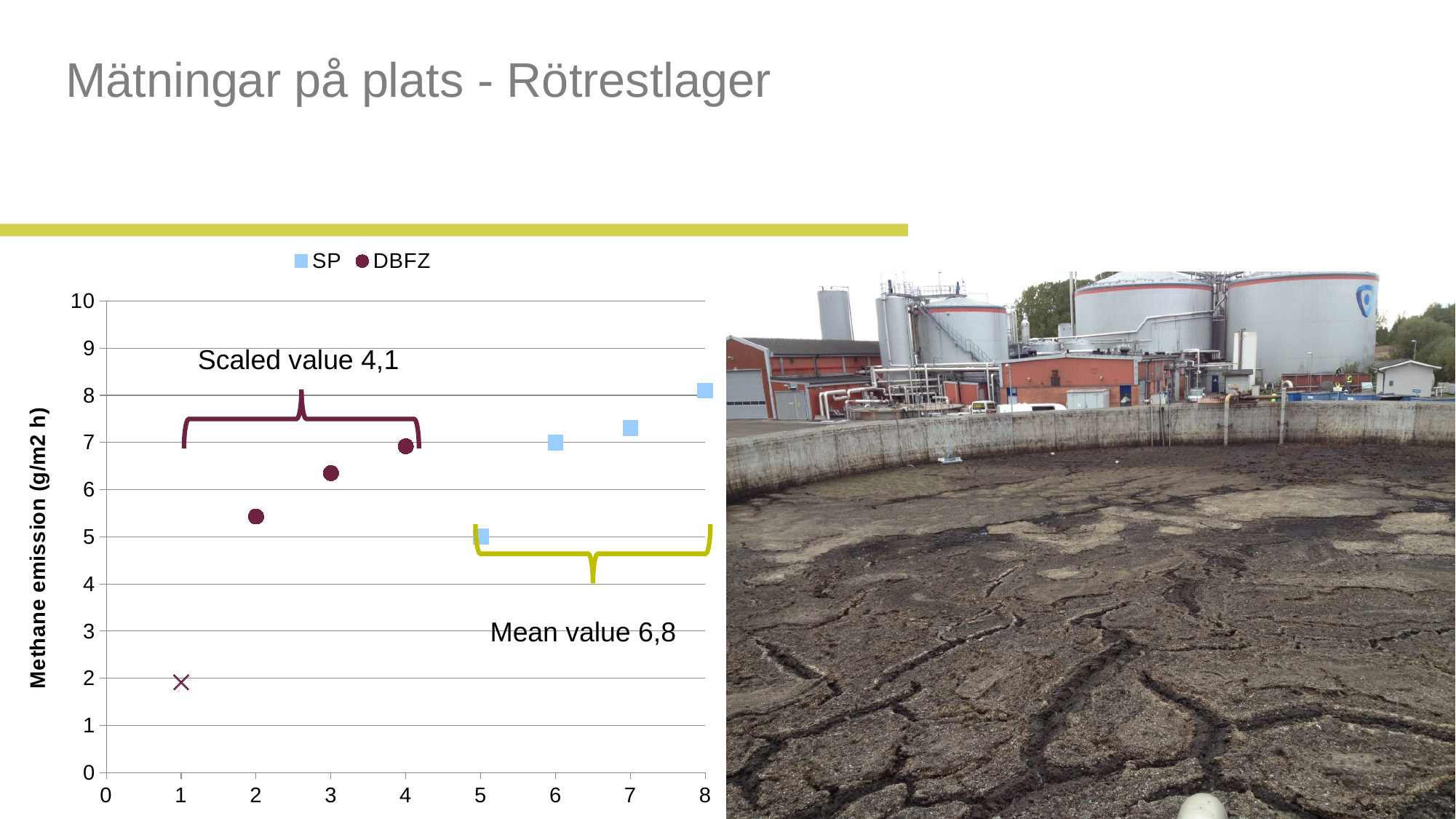
Do the SP values rise or fall as x increases from 5 to 8? rise How many series does the chart legend list? 2 How many SP data points are plotted on the chart? 4 What is the label of the chart's vertical axis? Methane emission (g/m2 h) At which x value is the lowest DBFZ point plotted? 1 Is the DBFZ value at x = 1 greater or less than 3? less What kind of chart is shown on the slide? scatter chart What scaled value is annotated for the DBFZ series? 4,1 What are the two series named in the chart legend? SP and DBFZ What mean value is annotated for the SP series? 6,8 At which x value is the highest SP point plotted? 8 Is the SP value at x = 8 greater or less than 7? greater